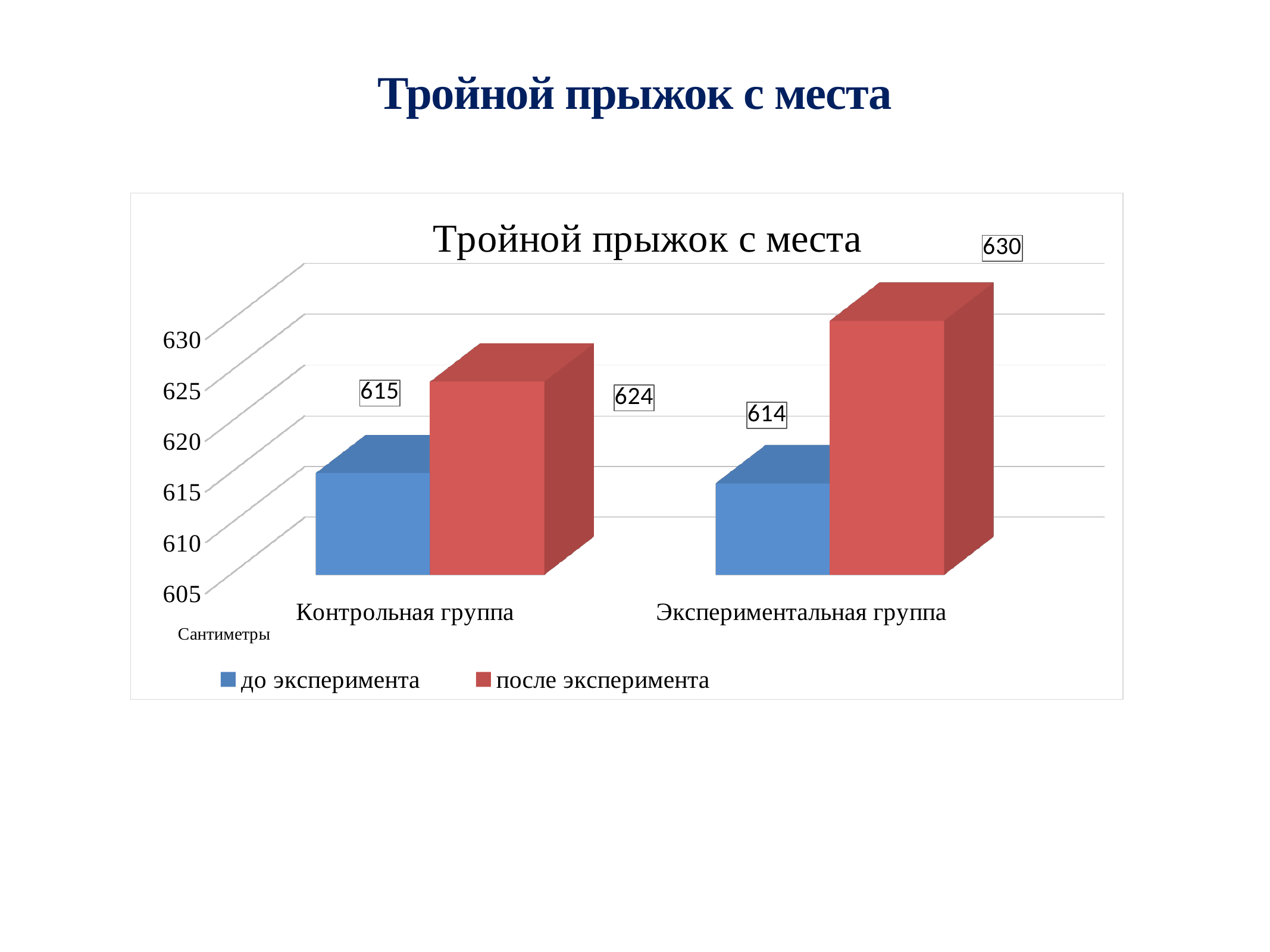
What is the value for 'Экспериментальная группа' in the 'после эксперимента' series? 630 How many categories are shown on the x axis? 2 What is the difference between the 'после эксперимента' and 'до эксперимента' values for 'Контрольная группа'? 9 How many series does the legend list? 2 Which group has the highest value in the 'после эксперимента' series? Экспериментальная группа What kind of chart is shown on the slide? Bar chart What is the value for 'Экспериментальная группа' in the 'до эксперимента' series? 614 Which group has the lowest value in the 'до эксперимента' series? Экспериментальная группа Which is larger: the 'после эксперимента' value for 'Контрольная группа' or for 'Экспериментальная группа'? Экспериментальная группа What is the difference between the 'после эксперимента' and 'до эксперимента' values for 'Экспериментальная группа'? 16 What is the value for 'Контрольная группа' in the 'после эксперимента' series? 624 What is the value for 'Контрольная группа' in the 'до эксперимента' series? 615